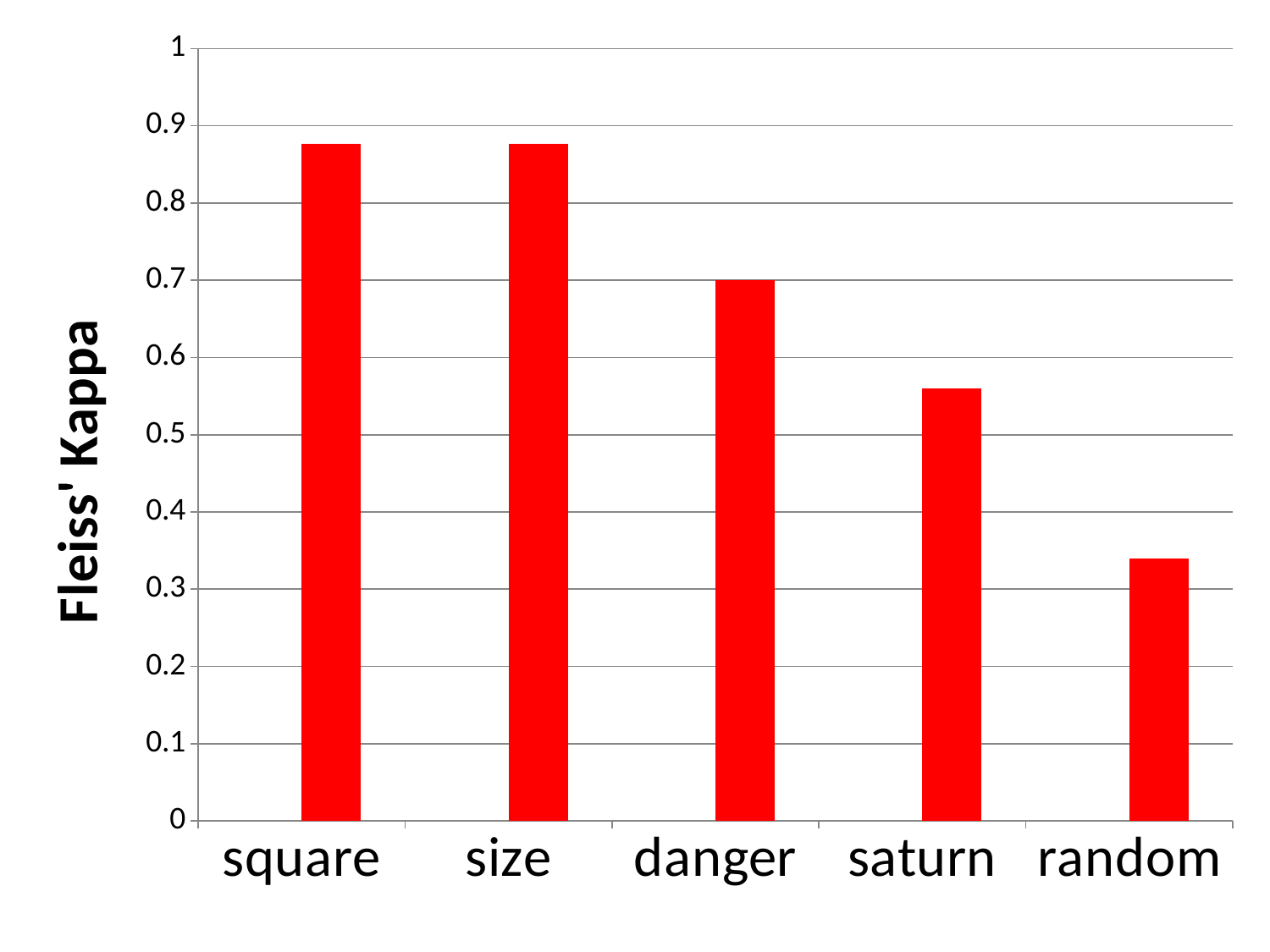
What is the label on the y axis of the chart? Fleiss' Kappa Is the Fleiss' Kappa value for size greater or less than 0.9? less Is the Fleiss' Kappa value for random greater or less than 0.4? less What kind of chart is shown on the slide? bar chart What is the Fleiss' Kappa value for danger? 0.7 Is the Fleiss' Kappa value for square greater or less than 0.8? greater Which category has the lowest Fleiss' Kappa value? random Which has a higher Fleiss' Kappa value, random or size? size Which has a higher Fleiss' Kappa value, danger or saturn? danger How many categories are shown on the x axis of the chart? 5 Do the Fleiss' Kappa values rise or fall moving from left to right along the x axis? fall